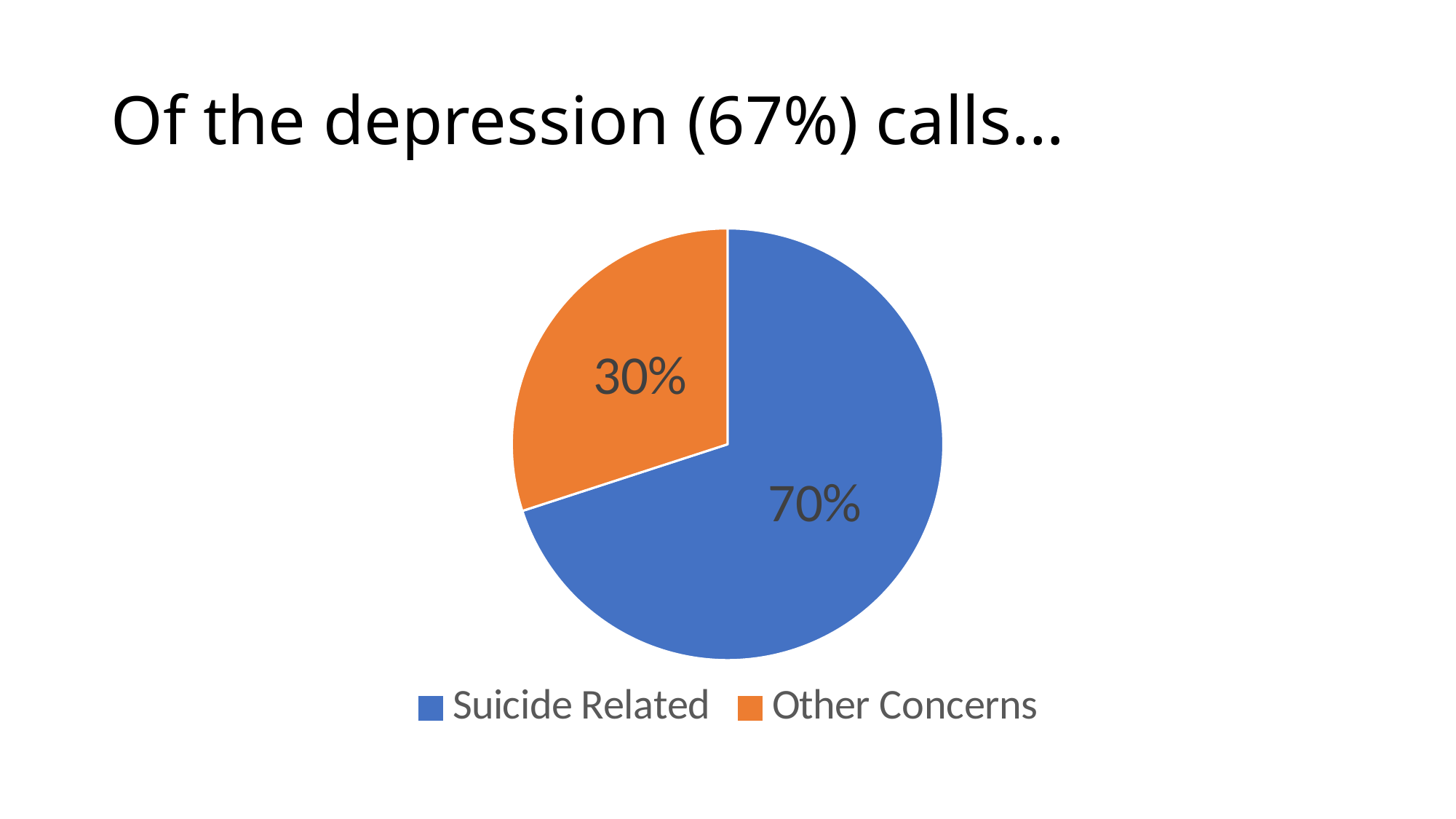
What is the title of the slide? Of the depression (67%) calls… What share of the pie is Suicide Related? 70% What kind of chart is shown on the slide? pie chart What is the difference in percentage points between Suicide Related and Other Concerns? 40 What share of the pie is Other Concerns? 30% Which slice of the pie is the smallest? Other Concerns Which slice of the pie is the largest? Suicide Related How many entries does the legend list? 2 Which is larger, Suicide Related or Other Concerns? Suicide Related How many slices does the pie chart have? 2 What colour is the Other Concerns slice? orange